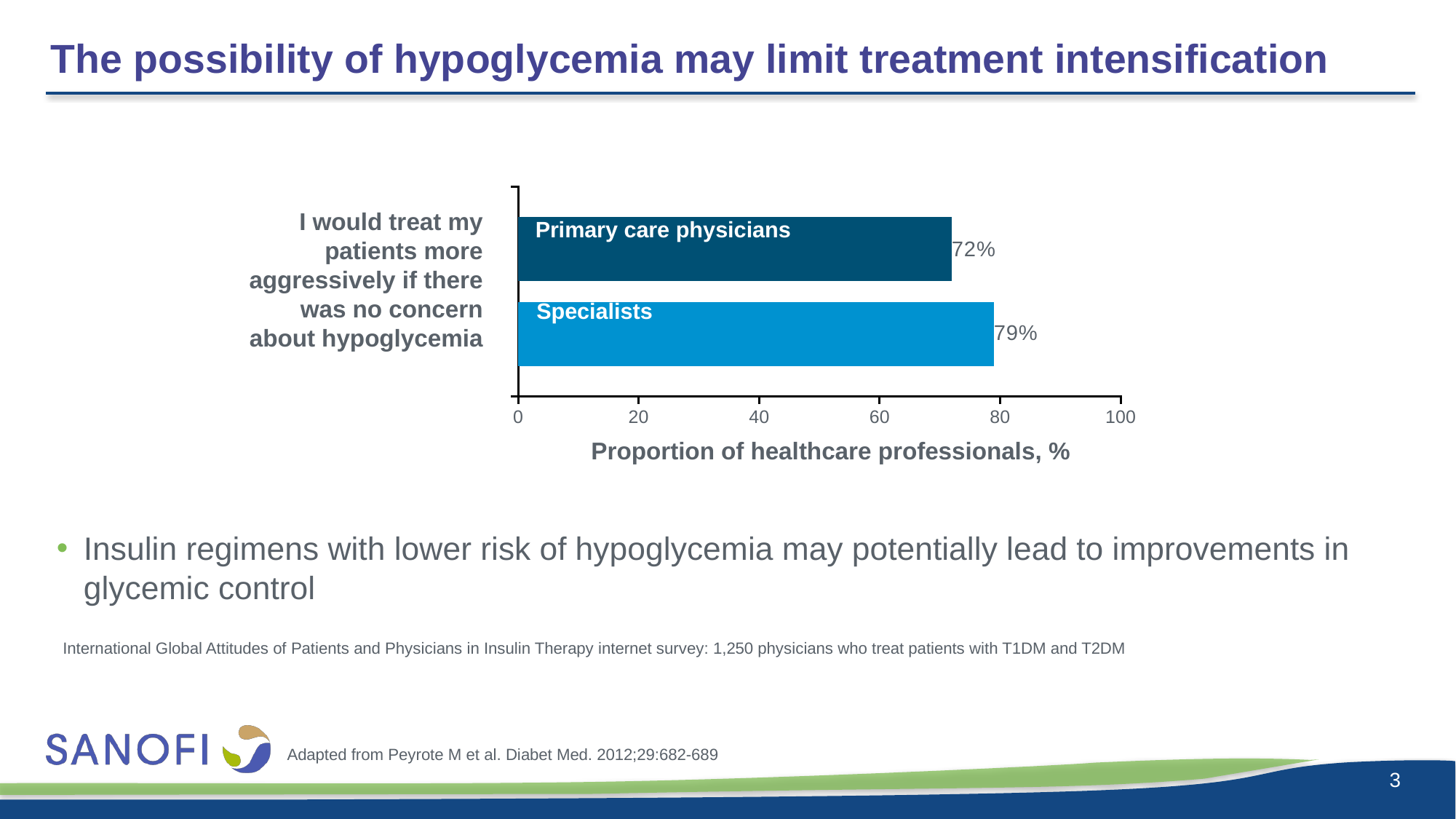
What percentage of specialists said they would treat patients more aggressively if there was no concern about hypoglycemia? 79% Which group has the higher proportion agreeing they would treat more aggressively without hypoglycemia concern? Specialists Is the value for primary care physicians greater or less than 80? less Is the value for specialists greater or less than 60? greater How many bars are shown in the chart? 2 What is the maximum value shown on the horizontal axis? 100 Is the value for primary care physicians larger or smaller than the value for specialists? smaller What percentage of primary care physicians said they would treat patients more aggressively if there was no concern about hypoglycemia? 72% What kind of chart is shown on the slide? Bar chart What is the difference in percentage points between specialists and primary care physicians? 7 Which group has the lower proportion agreeing they would treat more aggressively without hypoglycemia concern? Primary care physicians What is the label of the horizontal axis of the chart? Proportion of healthcare professionals, %